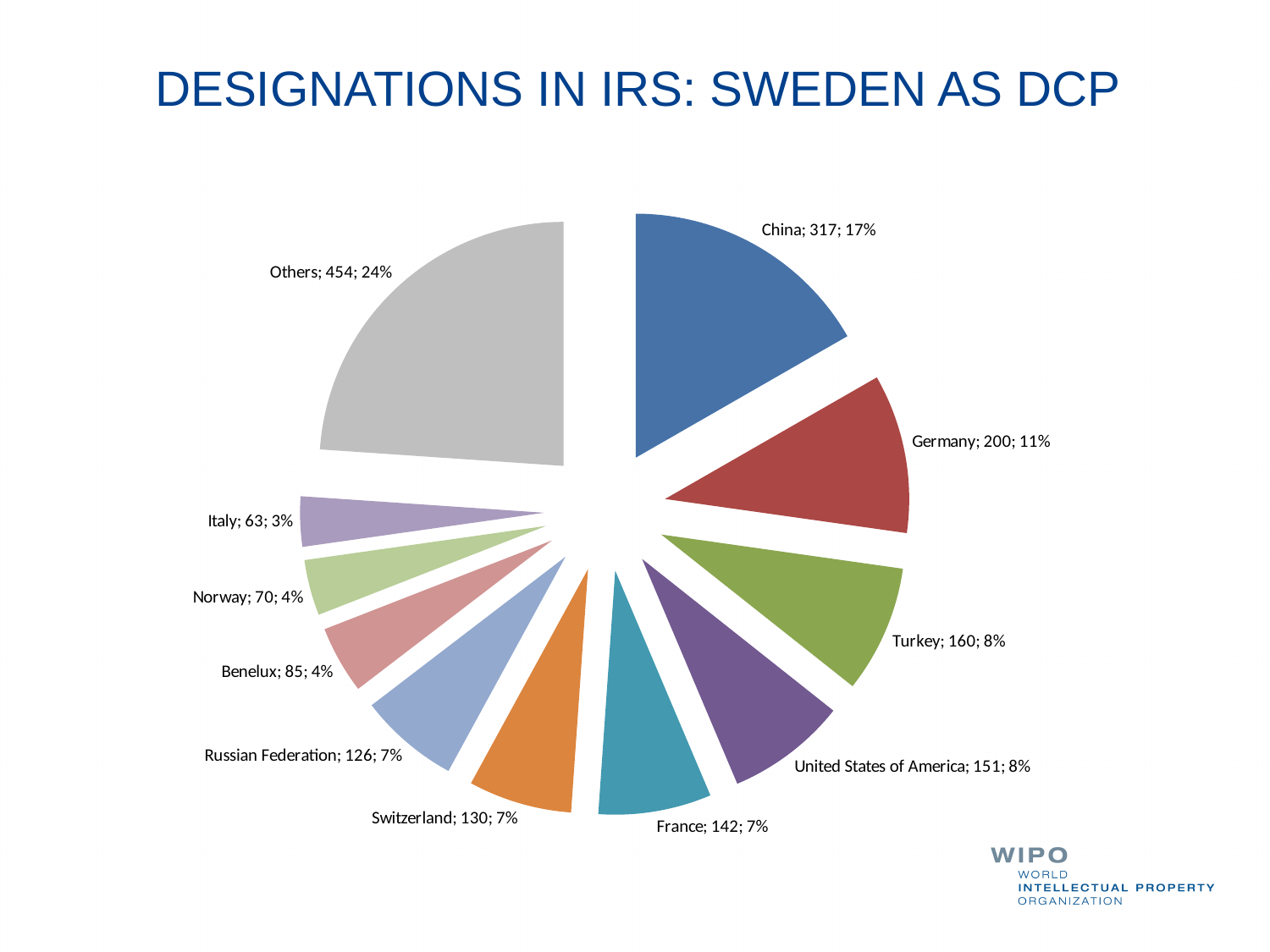
Which category has the largest slice? Others How many slices does the pie chart have? 11 Which category has the smallest slice? Italy What share of the pie does Turkey represent? 8% What is the difference between the values for China and Germany? 117 What is the title of the slide? DESIGNATIONS IN IRS: SWEDEN AS DCP What is the value for Germany? 200 What kind of chart is shown on the slide? pie chart What is the value for Benelux? 85 What is the value for China? 317 Which is larger, the value for Switzerland or the value for Russian Federation? Switzerland What share of the pie does Others represent? 24%